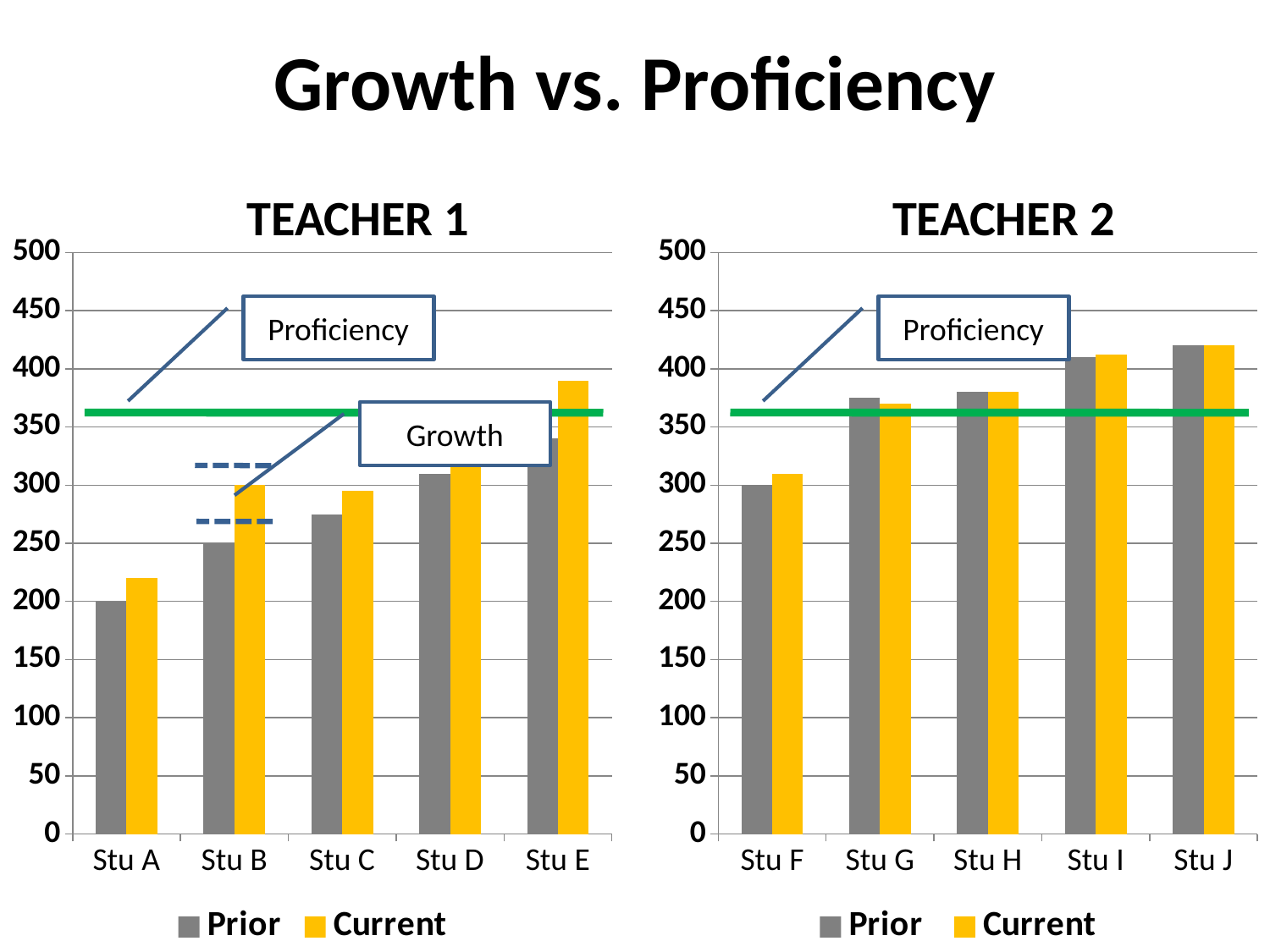
In the TEACHER 1 chart, what is the Prior value for Stu B? 250 In the TEACHER 1 chart, which student has the highest Current value? Stu E In the TEACHER 1 chart, is the Current value for Stu E greater or less than 350? greater How many series does the legend of the TEACHER 2 chart list? 2 How many students are shown on the x axis of the TEACHER 1 chart? 5 What kind of chart is the TEACHER 1 chart? bar chart In the TEACHER 1 chart, do the Prior values rise or fall from Stu A to Stu E? rise In the TEACHER 1 chart, what is the difference between the Current and Prior values for Stu B? 50 In the TEACHER 2 chart, what is the Prior value for Stu F? 300 In the TEACHER 2 chart, which student has the lowest Prior value? Stu F In the TEACHER 1 chart, what is the Prior value for Stu A? 200 In the TEACHER 1 chart, which is larger: the Current value for Stu A or the Current value for Stu C? Stu C